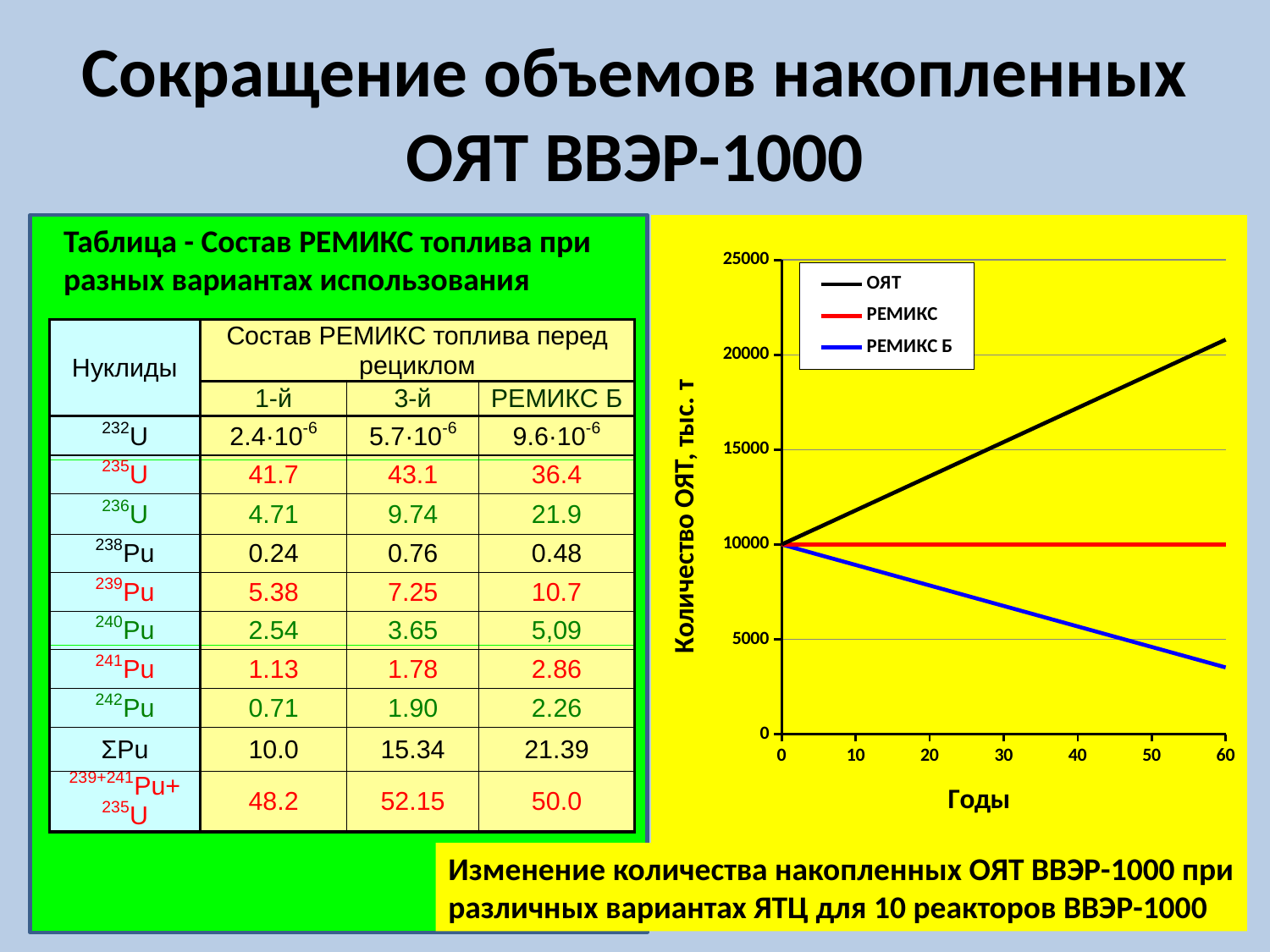
Is the value of ОЯТ at year 60 greater or less than 15000? greater What is the label of the x axis of the chart? Годы Does the РЕМИКС Б line rise or fall as the years increase? falls At year 60, which series has the highest value? ОЯТ Which series are listed in the chart's legend? ОЯТ, РЕМИКС, РЕМИКС Б Does the РЕМИКС line rise, fall or stay constant over the years? stays constant What kind of chart is shown on the right side of the slide? line chart Does the ОЯТ line rise or fall as the years increase? rises Is the value of РЕМИКС Б at year 60 greater or less than 5000? less What is the value of the РЕМИКС series at year 60? 10000 How many series does the legend of the chart list? 3 At year 0, what value do all three series start from? 10000